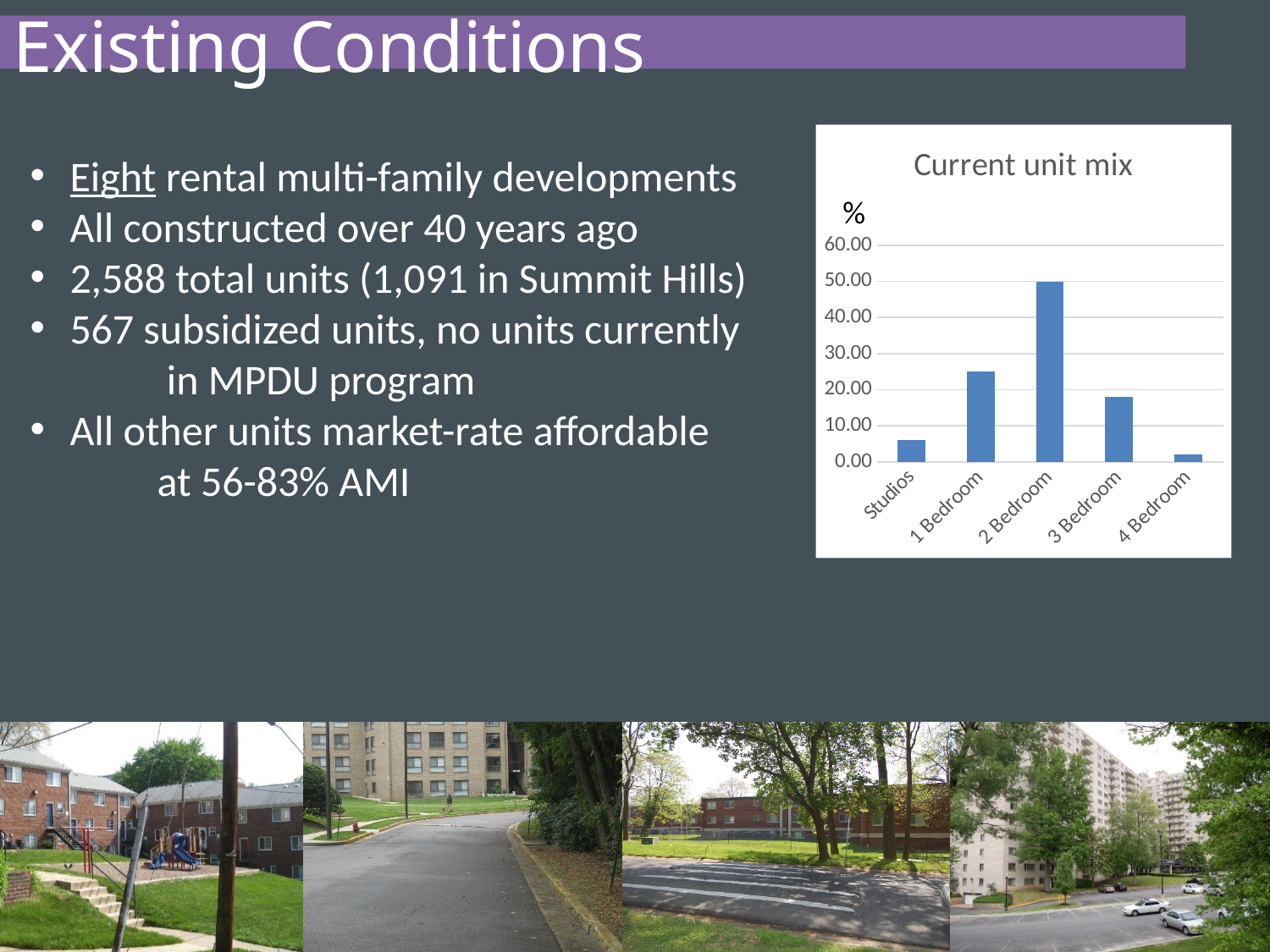
How many unit-type categories are shown on the x axis of the chart? 5 What is the title of the chart? Current unit mix What unit is indicated on the vertical axis of the chart? % Is the value for 3 Bedroom greater or less than 20.00? less Is the value for 1 Bedroom greater or less than 20.00? greater Is the value for 2 Bedroom greater or less than 40.00? greater What type of chart is shown on the slide? bar chart Which unit type has the highest share in the Current unit mix chart? 2 Bedroom Which unit type has the lowest share in the Current unit mix chart? 4 Bedroom Which is larger in the chart, the value for Studios or the value for 4 Bedroom? Studios Which is larger in the chart, the value for 1 Bedroom or the value for 3 Bedroom? 1 Bedroom